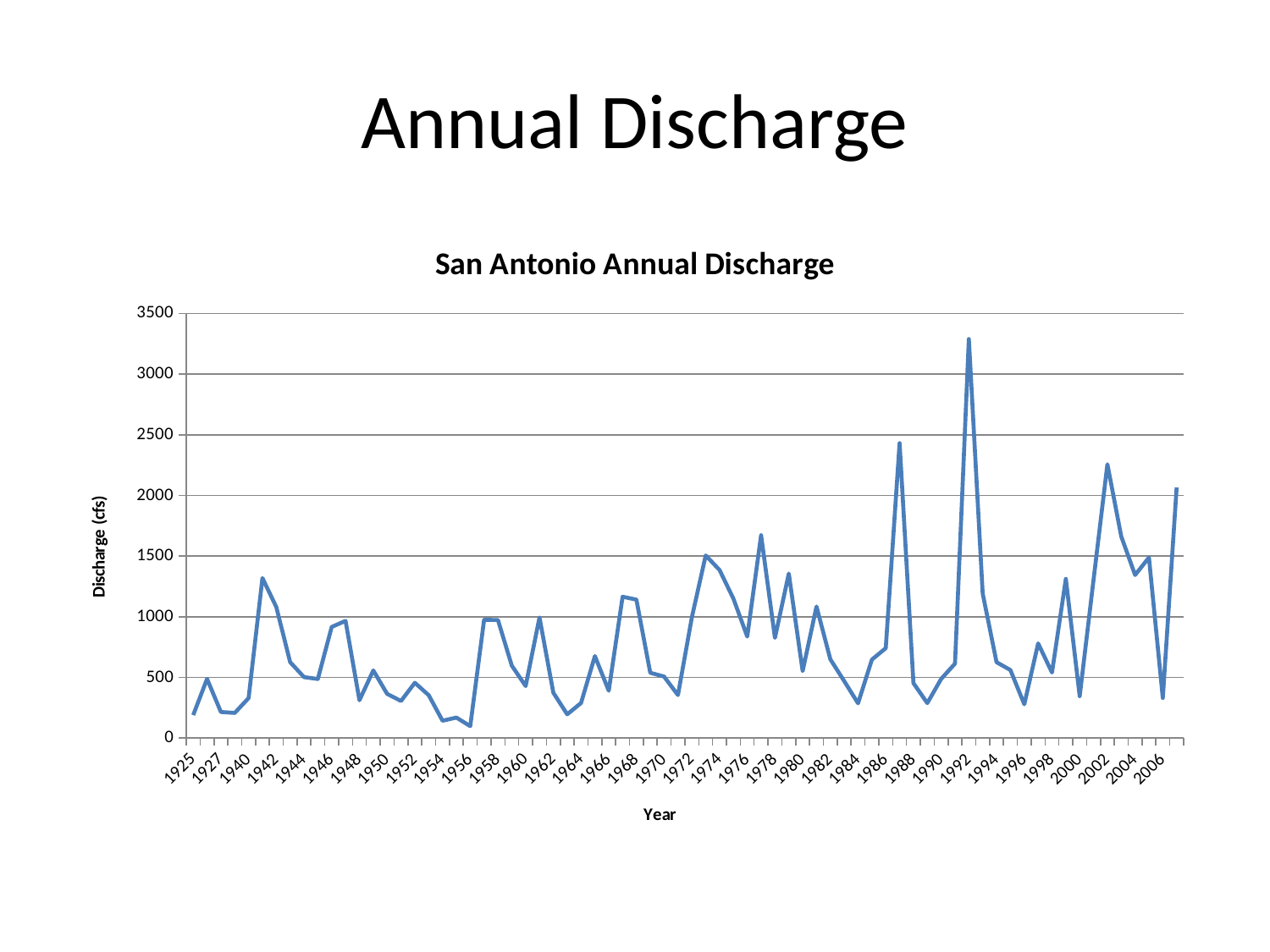
Is the discharge value for 1956 greater or less than 500? less In which year does the discharge reach its highest value? 1992 Is the discharge value for 2002 greater or less than 2000? greater What is the title of the chart? San Antonio Annual Discharge Which year has the larger discharge, 1977 or 1984? 1977 Is the discharge value for 1992 greater or less than 3000? greater What is the label of the vertical axis? Discharge (cfs) What kind of chart is shown on the slide? line chart Does the discharge rise or fall from 1990 to 1992? rise Which year has the larger discharge, 1992 or 1987? 1992